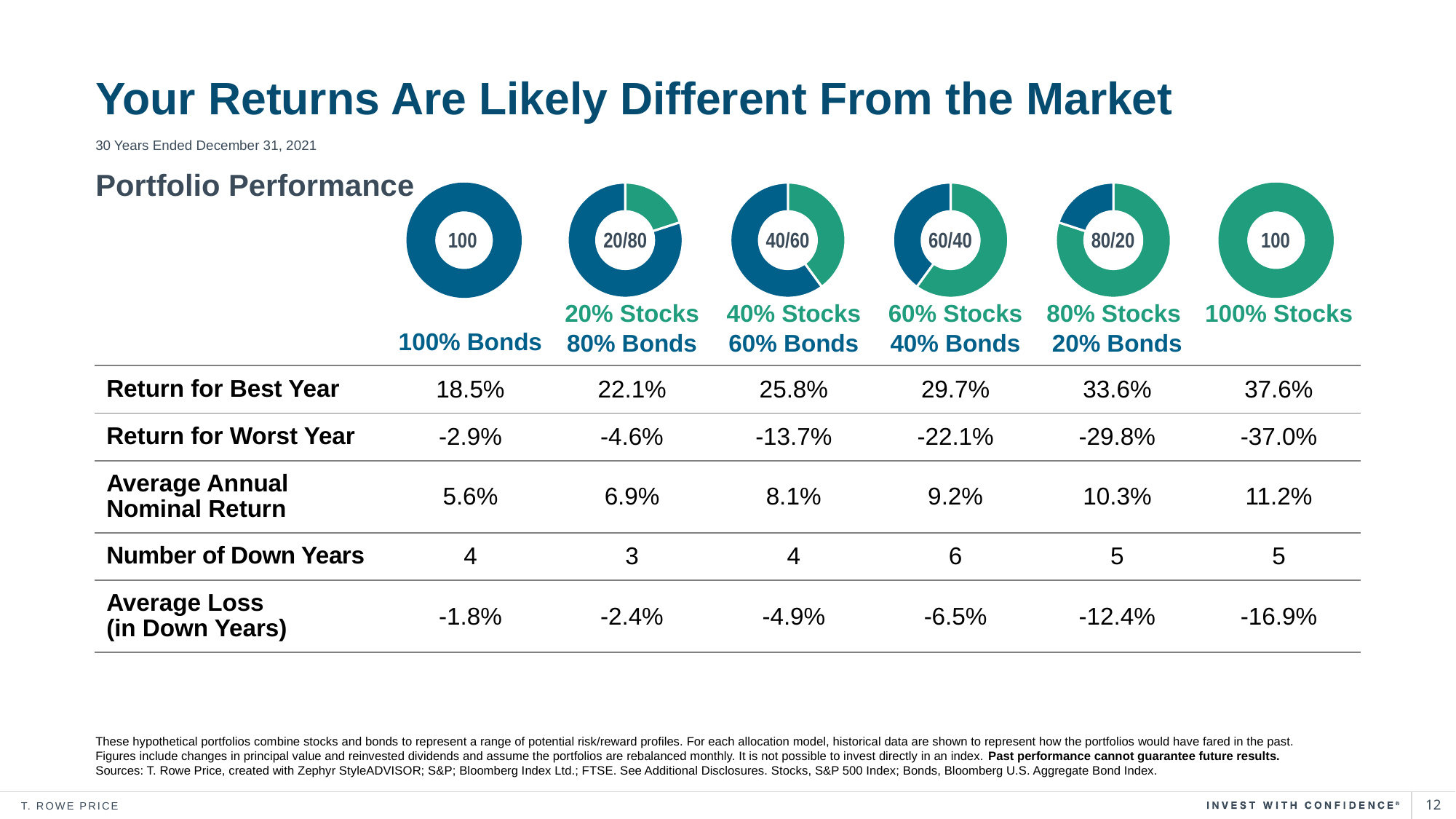
In the donut chart labelled 80/20, what share of the portfolio is stocks? 80% How many donut charts are shown on the slide? 6 In the donut chart labelled 20/80, what share of the portfolio is stocks? 20% In the donut chart labelled 60/40, what share of the portfolio is bonds? 40% What is the Average Annual Nominal Return shown for the 60/40 (60% Stocks, 40% Bonds) portfolio? 9.2% Moving from the 100% Bonds donut to the 100% Stocks donut, does the stock share rise or fall? Rise In the donut chart labelled 40/60, which slice is larger, stocks or bonds? Bonds Which donut chart shows the smallest bond share? 100% Stocks Which donut chart shows the largest stock share? 100% Stocks What colour represents bonds in the donut charts? Dark blue What kind of charts are the six circular charts shown under 'Portfolio Performance'? Donut (pie) charts What colour represents stocks in the donut charts? Green